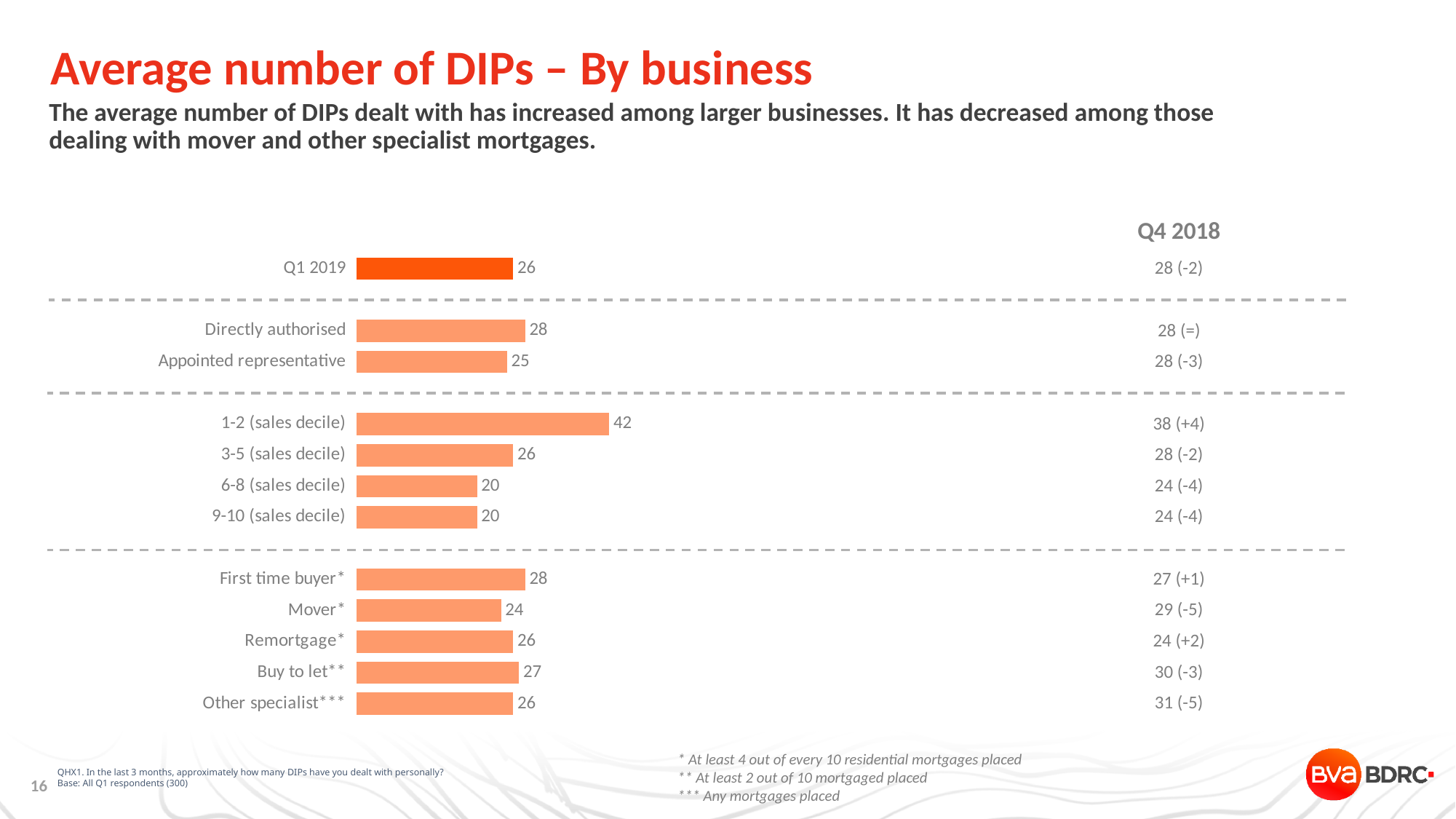
What is the average number of DIPs for Appointed representative in Q1 2019? 25 Which category has the highest average number of DIPs in Q1 2019? 1-2 (sales decile) What is the difference between the Q1 2019 values for 1-2 (sales decile) and 3-5 (sales decile)? 16 What kind of chart is shown on the slide? Bar chart What is the difference between the Q1 2019 value for First time buyer* and the Q1 2019 value for Remortgage*? 2 What is the title of the slide's chart? Average number of DIPs – By business What is the Q1 2019 value for Mover*? 24 What is the average number of DIPs for 1-2 (sales decile) in Q1 2019? 42 What is the Q4 2018 value shown for Other specialist***? 31 (-5) How many bars are plotted in the chart? 12 Which has a higher Q1 2019 value, Directly authorised or Appointed representative? Directly authorised Which has a higher Q1 2019 value, Buy to let** or Mover*? Buy to let**